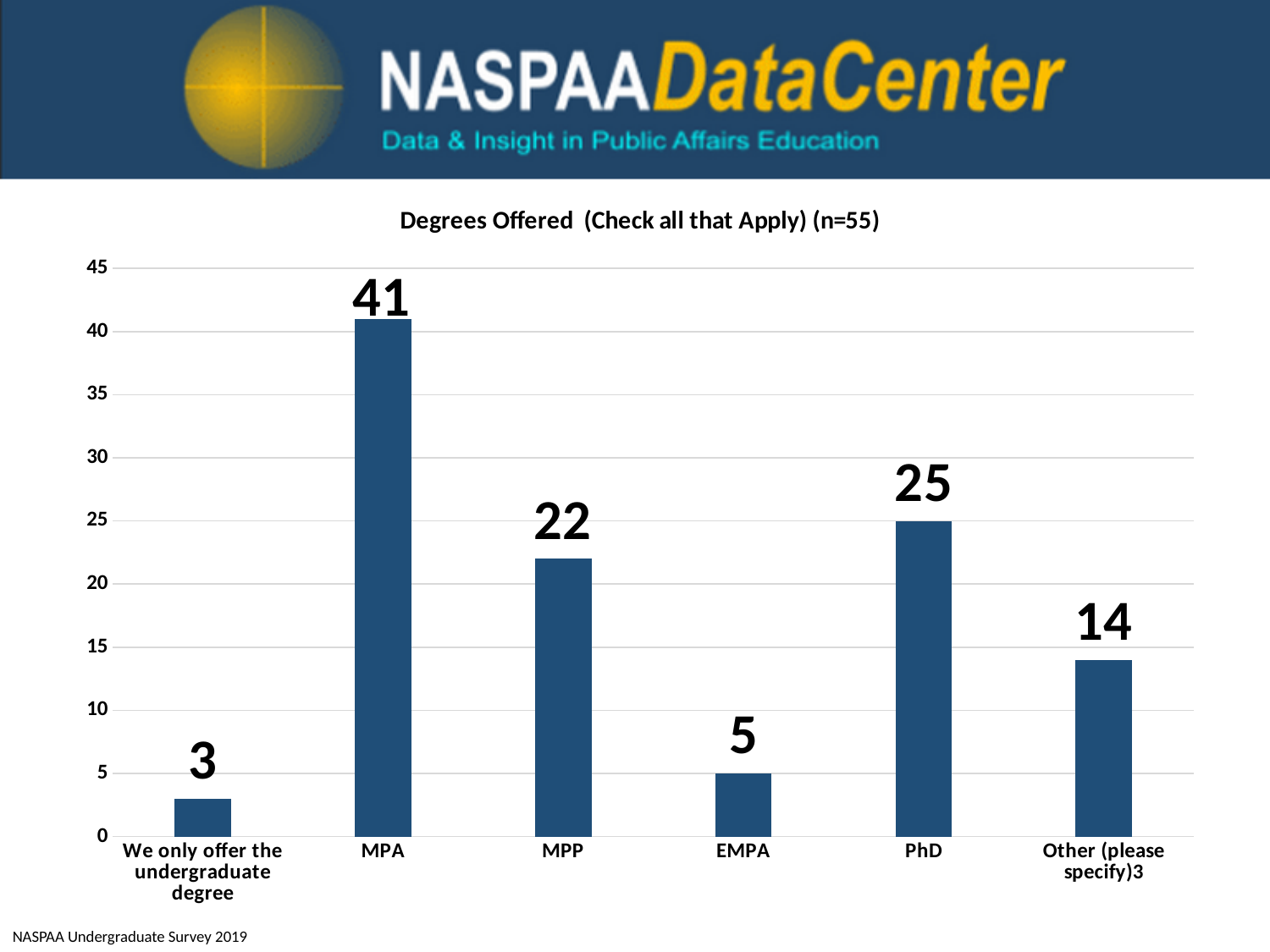
What kind of chart is shown on the slide? Bar chart What is the value for 'We only offer the undergraduate degree'? 3 What is the title of the chart? Degrees Offered (Check all that Apply) (n=55) Which category has the lowest value? We only offer the undergraduate degree Which category has the highest value? MPA What is the difference between the values for PhD and Other (please specify)? 11 What is the difference between the values for MPA and MPP? 19 How many categories are shown on the x axis? 6 What is the value for EMPA? 5 Which is larger, the value for MPP or the value for PhD? PhD What is the value for MPA? 41 What is the value for PhD? 25